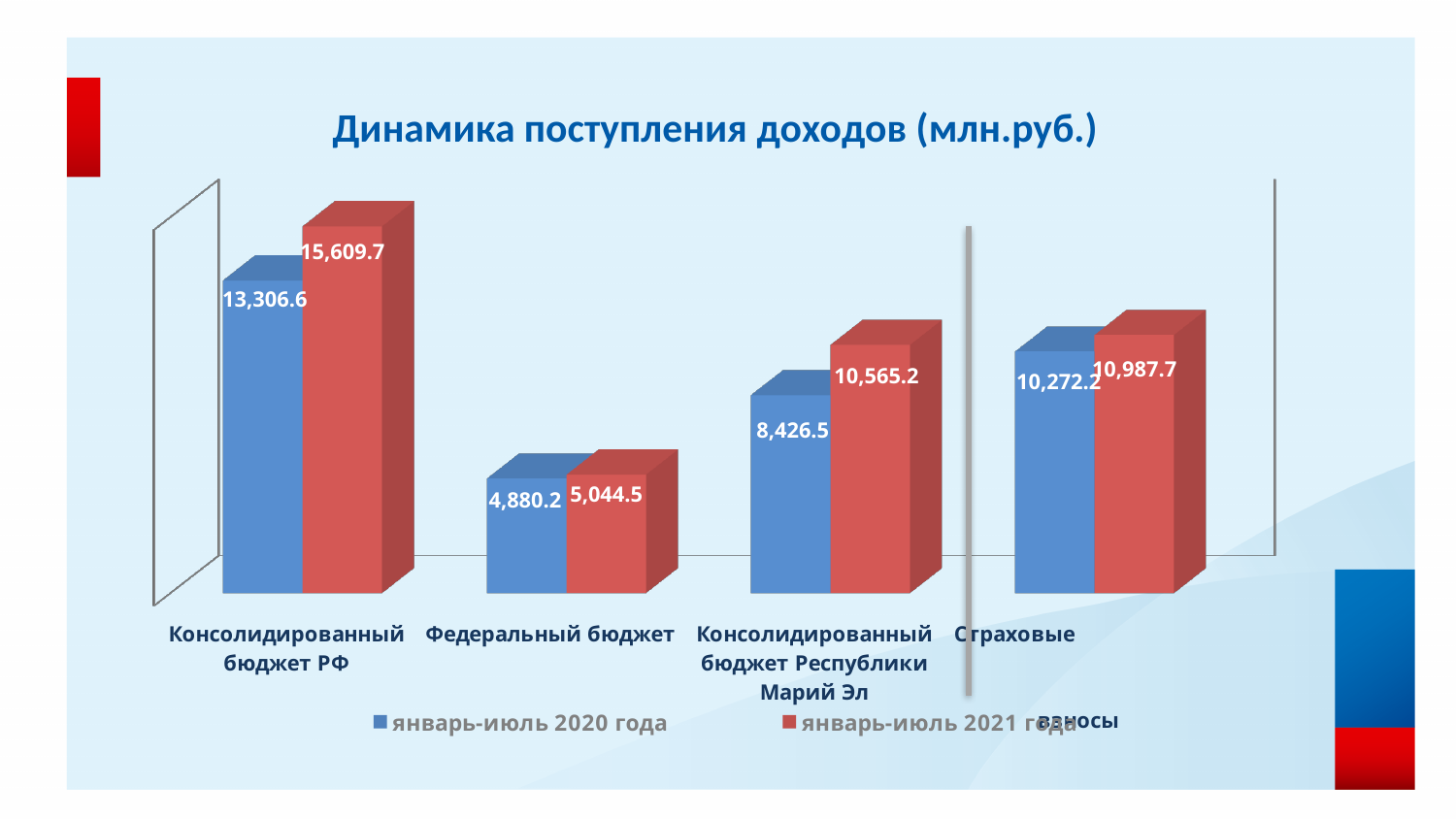
What is the difference between the январь-июль 2021 года and январь-июль 2020 года values for Федеральный бюджет? 164.3 How many categories are shown on the x axis? 4 What is the value for Федеральный бюджет in the январь-июль 2020 года series? 4,880.2 What is the value for Консолидированный бюджет РФ in the январь-июль 2021 года series? 15,609.7 What is the value for Консолидированный бюджет Республики Марий Эл in the январь-июль 2021 года series? 10,565.2 What is the difference between the январь-июль 2021 года and январь-июль 2020 года values for Консолидированный бюджет Республики Марий Эл? 2,138.7 What type of chart is shown on the slide? bar chart How many series does the legend list? 2 Which category has the highest value in the январь-июль 2021 года series? Консолидированный бюджет РФ Which category has the lowest value in the январь-июль 2020 года series? Федеральный бюджет What is the value for Страховые взносы in the январь-июль 2020 года series? 10,272.2 Which is larger for Страховые взносы: the январь-июль 2020 года value or the январь-июль 2021 года value? январь-июль 2021 года